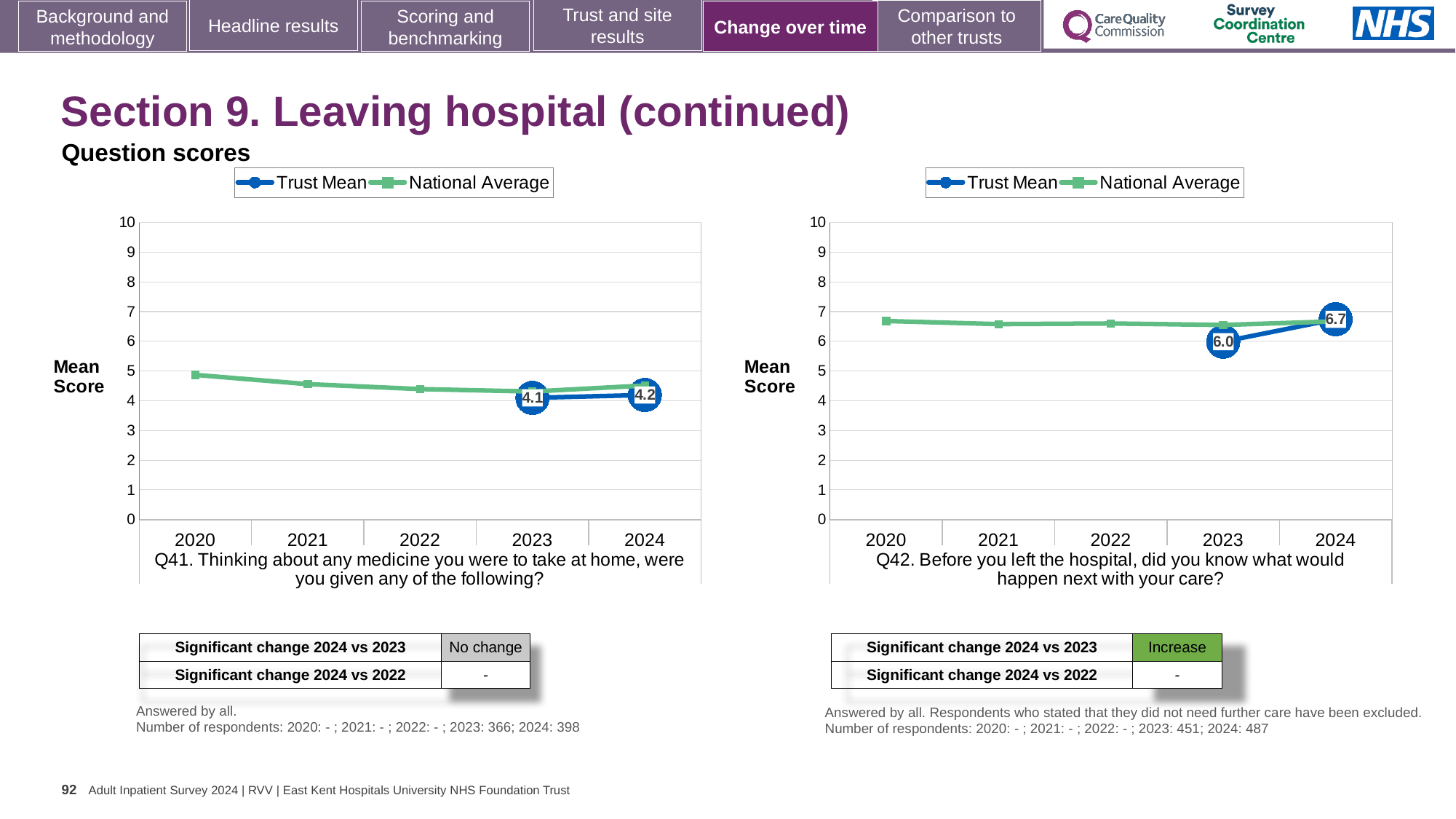
In the Q41 chart on the left, is the National Average value for 2020 greater or less than 4? greater In the Q41 chart on the left, what is the Trust Mean value for 2024? 4.2 What type of chart is used for Q41 on the left? line chart How many years are shown on the x axis of the Q41 chart on the left? 5 In the Q42 chart on the right, what is the Trust Mean value for 2023? 6.0 In the Q42 chart on the right, is the National Average value for 2021 greater or less than 7? less How many series does the legend of the Q42 chart on the right list? 2 In the Q42 chart on the right, did the Trust Mean rise or fall from 2023 to 2024? rise In the Q42 chart on the right, by how much did the Trust Mean change from 2023 to 2024? 0.7 In the Q42 chart on the right, what is the Trust Mean value for 2024? 6.7 In the Q41 chart on the left, what is the Trust Mean value for 2023? 4.1 In the Q41 chart on the left, what is the difference between the Trust Mean for 2024 and 2023? 0.1